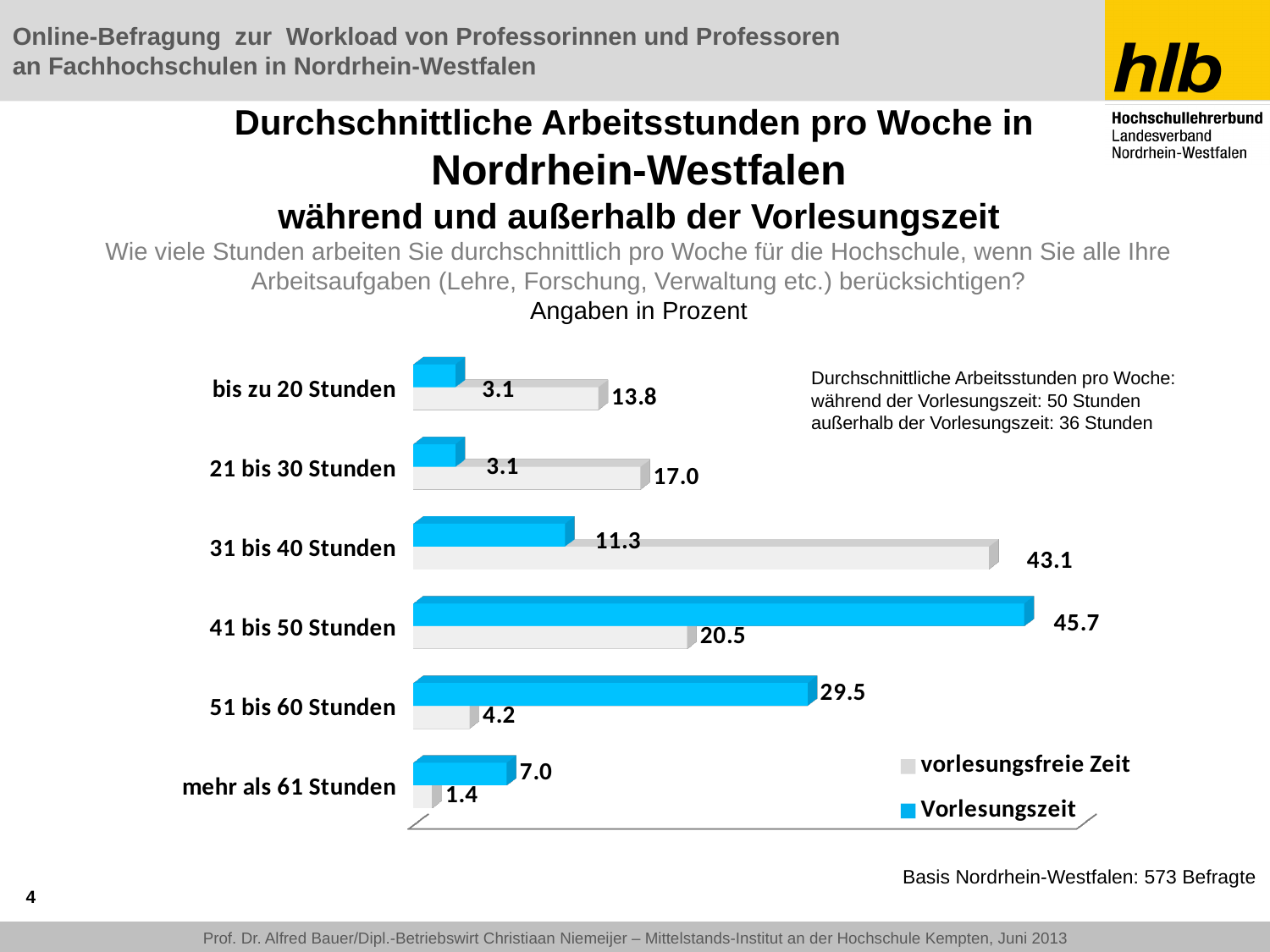
What is the value for "vorlesungsfreie Zeit" in the category "31 bis 40 Stunden"? 43.1 What is the value for "vorlesungsfreie Zeit" in the category "mehr als 61 Stunden"? 1.4 How many series does the legend list? 2 What is the difference between the "Vorlesungszeit" values for "41 bis 50 Stunden" and "51 bis 60 Stunden"? 16.2 Which category has the lowest value for "vorlesungsfreie Zeit"? mehr als 61 Stunden What kind of chart is shown on the slide? bar chart What is the difference between the "vorlesungsfreie Zeit" and "Vorlesungszeit" values in the category "31 bis 40 Stunden"? 31.8 Which category has the highest value for "Vorlesungszeit"? 41 bis 50 Stunden In the category "51 bis 60 Stunden", which series has the larger value, "Vorlesungszeit" or "vorlesungsfreie Zeit"? Vorlesungszeit How many categories are shown on the chart? 6 What is the value for "Vorlesungszeit" in the category "41 bis 50 Stunden"? 45.7 Which colour represents the series "Vorlesungszeit" in the legend? blue